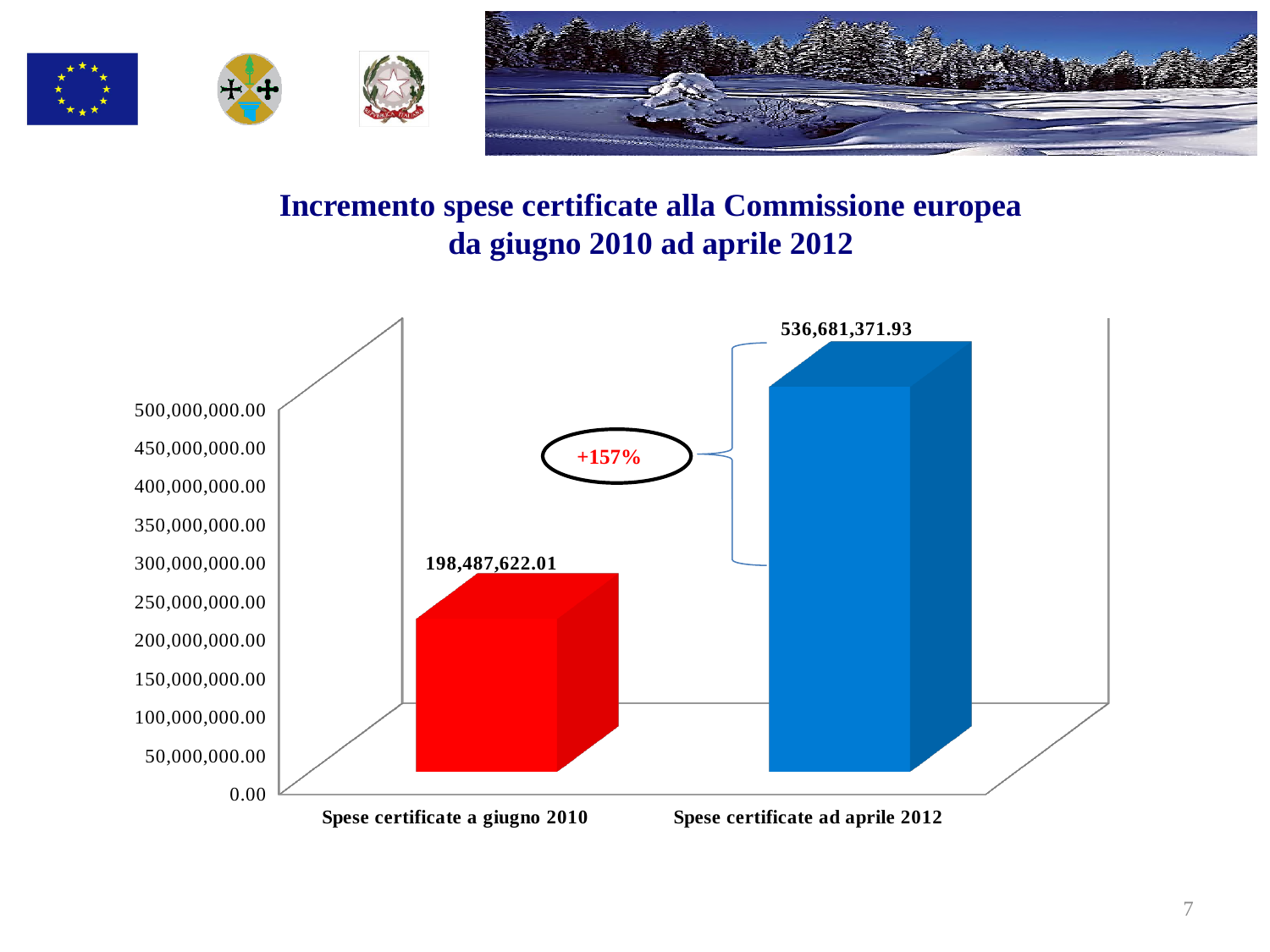
Which is larger: the value for "Spese certificate a giugno 2010" or the value for "Spese certificate ad aprile 2012"? Spese certificate ad aprile 2012 What is the value for "Spese certificate a giugno 2010"? 198,487,622.01 Is the value for "Spese certificate a giugno 2010" greater or less than 250,000,000.00? less What kind of chart is shown on the slide? Bar chart What is the difference between the value for "Spese certificate ad aprile 2012" and the value for "Spese certificate a giugno 2010"? 338,193,749.92 What is the value for "Spese certificate ad aprile 2012"? 536,681,371.93 Which category has the lowest value? Spese certificate a giugno 2010 Which category has the highest value? Spese certificate ad aprile 2012 How many bars are shown in the chart? 2 Is the value for "Spese certificate ad aprile 2012" greater or less than 500,000,000.00? greater What colour is the bar for "Spese certificate a giugno 2010"? Red What percentage increase is shown in the annotation between the two bars? +157%